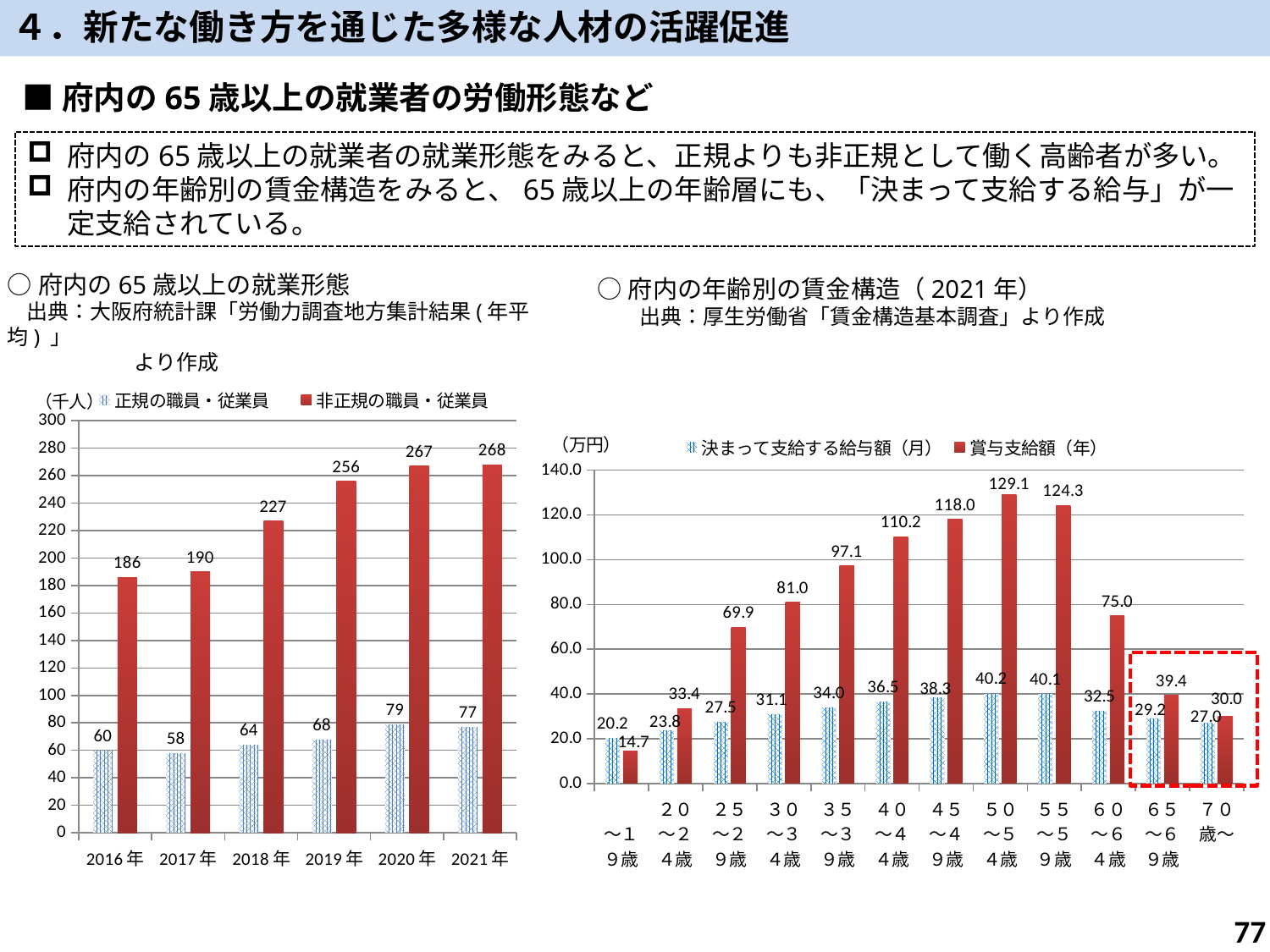
右の「府内の年齢別の賃金構造（2021年）」のグラフで、70歳～の決まって支給する給与額（月）と賞与支給額（年）ではどちらが大きいですか。 賞与支給額（年） 左の「府内の65歳以上の就業形態」のグラフで、非正規の職員・従業員の値は2016年から2021年にかけて増加していますか、減少していますか。 増加 右の「府内の年齢別の賃金構造（2021年）」のグラフで、賞与支給額（年）が最も低い年齢層はどれですか。 ～19歳 右の「府内の年齢別の賃金構造（2021年）」のグラフの凡例には系列がいくつありますか。 2 右の「府内の年齢別の賃金構造（2021年）」のグラフで、60～64歳と65～69歳の賞与支給額（年）の差はいくつですか。 35.6 左の「府内の65歳以上の就業形態」のグラフには何年分のデータがありますか。 6 左の「府内の65歳以上の就業形態」のグラフで、2021年の非正規の職員・従業員の値はいくつですか。 268 右の「府内の年齢別の賃金構造（2021年）」のグラフで、50～54歳の賞与支給額（年）はいくつですか。 129.1 左の「府内の65歳以上の就業形態」のグラフで、2016年の非正規と正規の職員・従業員の差はいくつですか。 126 左の「府内の65歳以上の就業形態」のグラフで、2017年の正規の職員・従業員の値はいくつですか。 58 右の「府内の年齢別の賃金構造（2021年）」のグラフで、65～69歳の決まって支給する給与額（月）はいくつですか。 29.2 左の「府内の65歳以上の就業形態」のグラフで、正規の職員・従業員が最も多い年はどれですか。 2020年